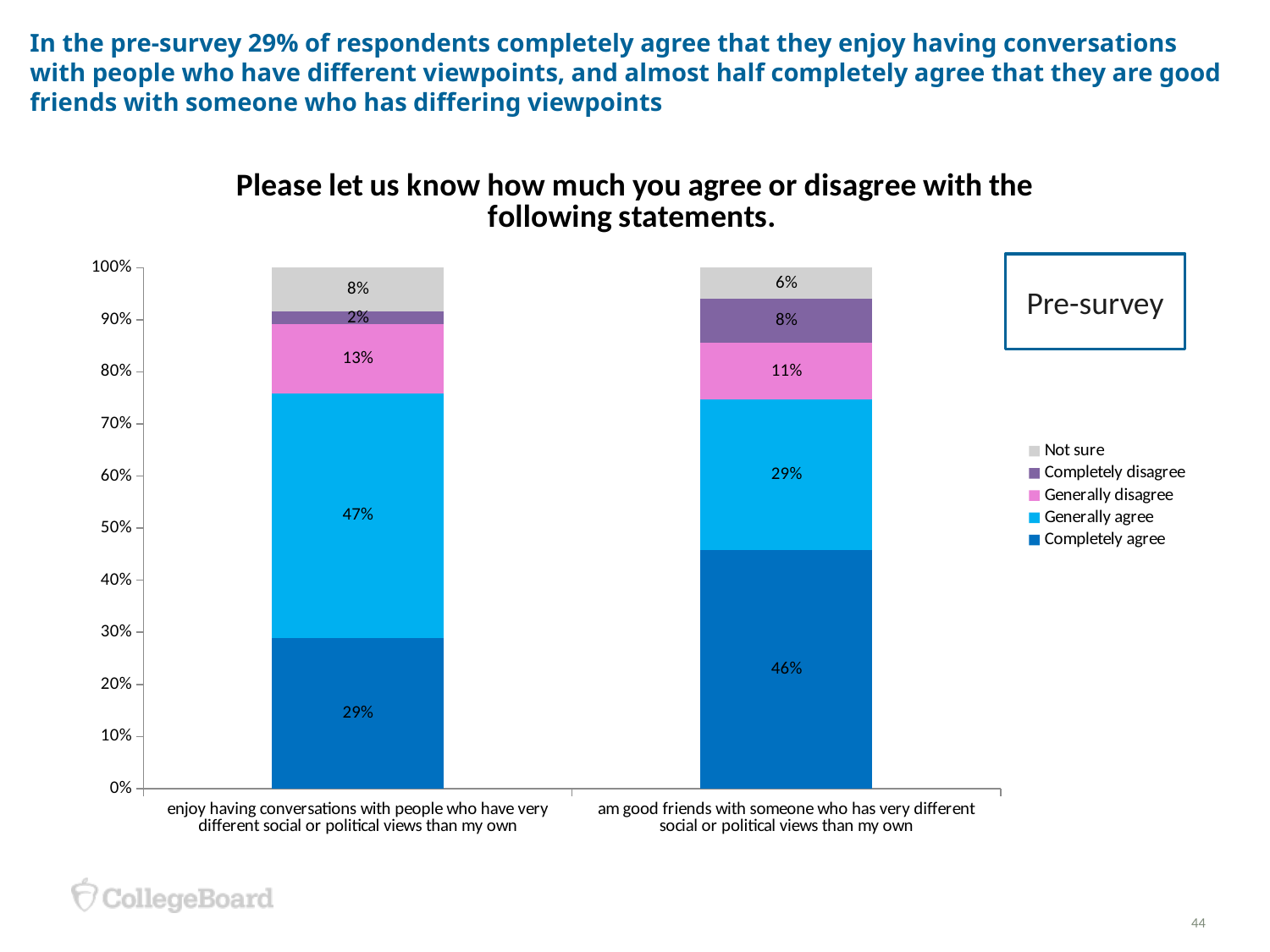
What label appears in the box to the right of the chart? Pre-survey What is the combined share of 'Completely agree' and 'Generally agree' for the statement about being good friends with someone who has very different views? 75% Which statement has the larger 'Generally disagree' share? enjoy having conversations with people who have very different social or political views than my own How many statements (categories) are shown on the x axis? 2 How many series does the legend list? 5 What percentage of respondents completely agree that they are good friends with someone who has very different social or political views than their own? 46% What percentage of respondents completely agree that they enjoy having conversations with people who have very different social or political views than their own? 29% What is the 'Generally agree' value for the statement about enjoying conversations with people who have very different views? 47% What is the difference between the 'Completely agree' values for the two statements? 17% What is the 'Completely disagree' value for the statement about enjoying conversations with people who have very different views? 2% What kind of chart is shown on the slide? Stacked bar chart What is the 'Not sure' value for the statement about being good friends with someone who has very different views? 6%